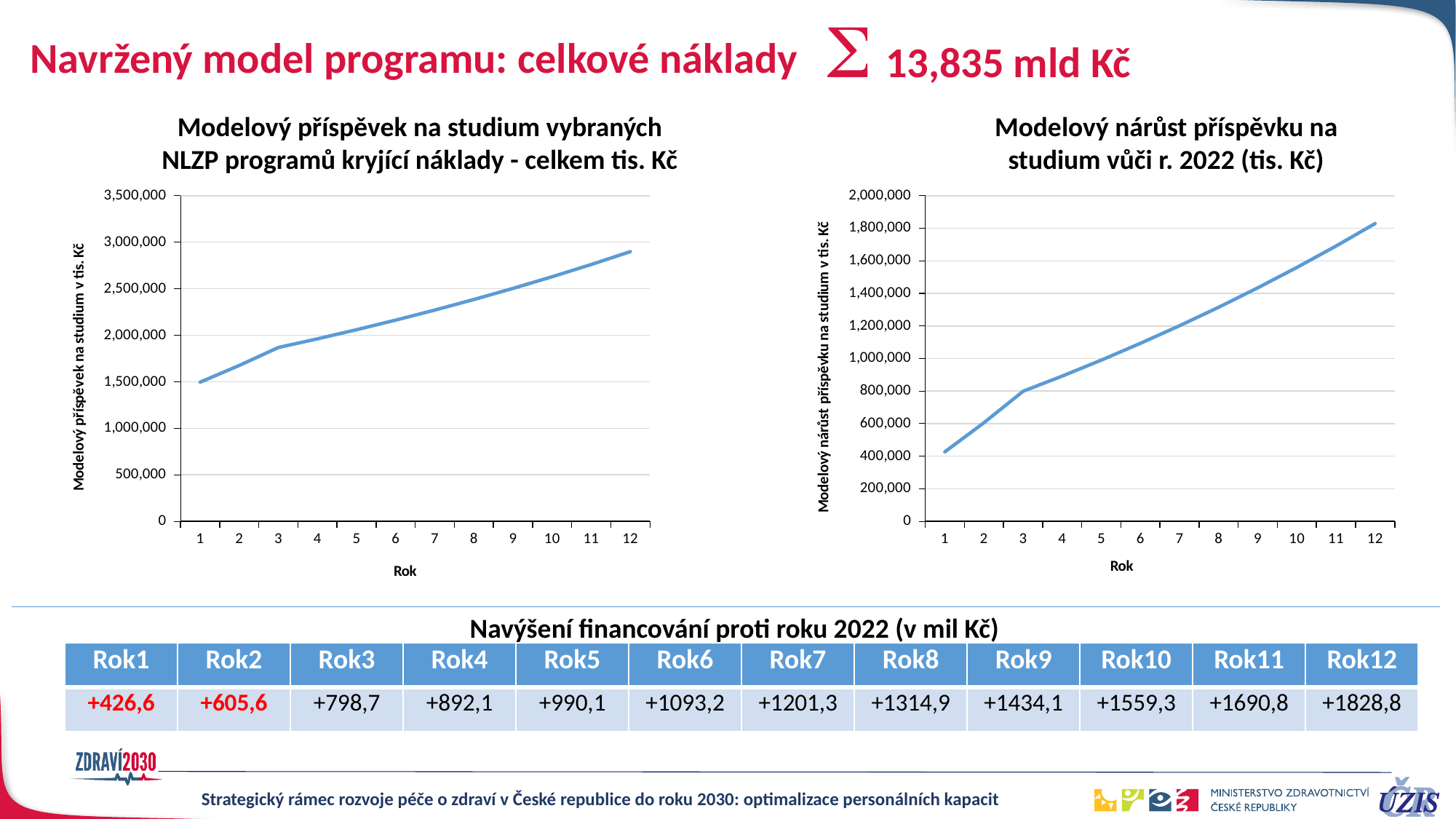
In the left chart, is the value for year 12 greater or less than 3,000,000? less In the left chart, is the value for year 3 greater or less than 1,500,000? greater What kind of chart is the left chart, 'Modelový příspěvek na studium vybraných NLZP programů kryjící náklady - celkem tis. Kč'? line chart In the right chart, which year has the highest value? 12 In the left chart, do the values rise or fall as the year increases from 1 to 12? rise What is the label of the x axis on the left chart? Rok In the left chart, which year has the lowest value? 1 How many years (points) are plotted on the x axis of the right chart, 'Modelový nárůst příspěvku na studium vůči r. 2022 (tis. Kč)'? 12 In the right chart, which is larger: the value for year 5 or the value for year 10? year 10 In the right chart, is the value for year 8 greater or less than 1,400,000? less What is the title of the right chart? Modelový nárůst příspěvku na studium vůči r. 2022 (tis. Kč)